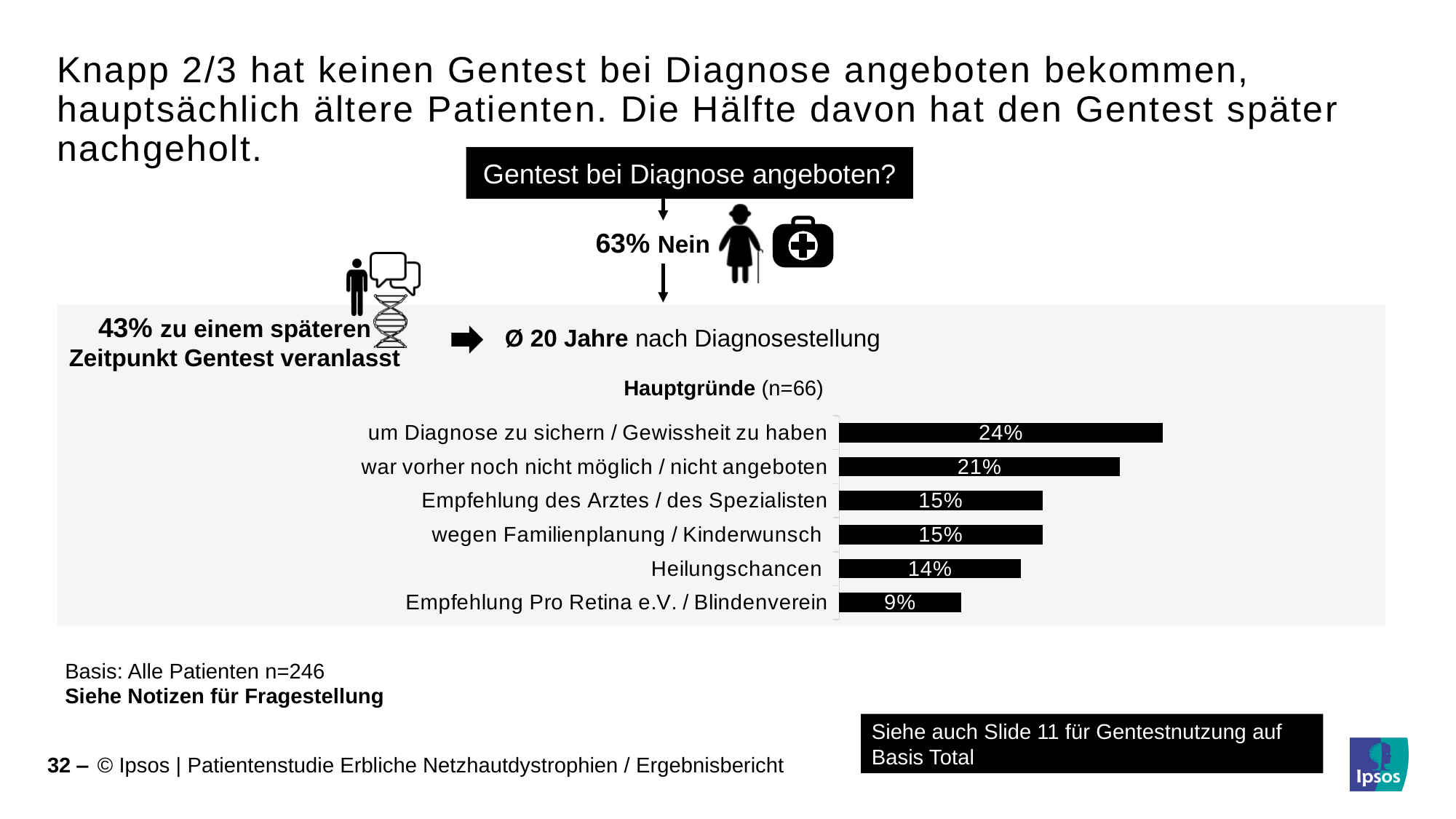
How many categories are shown in the Hauptgründe chart? 6 What is the difference between the values for "Empfehlung des Arztes / des Spezialisten" and "Empfehlung Pro Retina e.V. / Blindenverein" in the Hauptgründe chart? 6% Which category has the highest value in the Hauptgründe chart? um Diagnose zu sichern / Gewissheit zu haben What is the sample size (n) given in the title of the Hauptgründe chart? n=66 What kind of chart is the Hauptgründe chart? Bar chart Which is larger in the Hauptgründe chart: "Heilungschancen" or "Empfehlung Pro Retina e.V. / Blindenverein"? Heilungschancen What is the value for "Empfehlung Pro Retina e.V. / Blindenverein" in the Hauptgründe chart? 9% What is the value for "um Diagnose zu sichern / Gewissheit zu haben" in the Hauptgründe chart? 24% What is the difference between the values for "um Diagnose zu sichern / Gewissheit zu haben" and "war vorher noch nicht möglich / nicht angeboten" in the Hauptgründe chart? 3% Which category has the lowest value in the Hauptgründe chart? Empfehlung Pro Retina e.V. / Blindenverein What is the value for "war vorher noch nicht möglich / nicht angeboten" in the Hauptgründe chart? 21% What is the value for "Heilungschancen" in the Hauptgründe chart? 14%